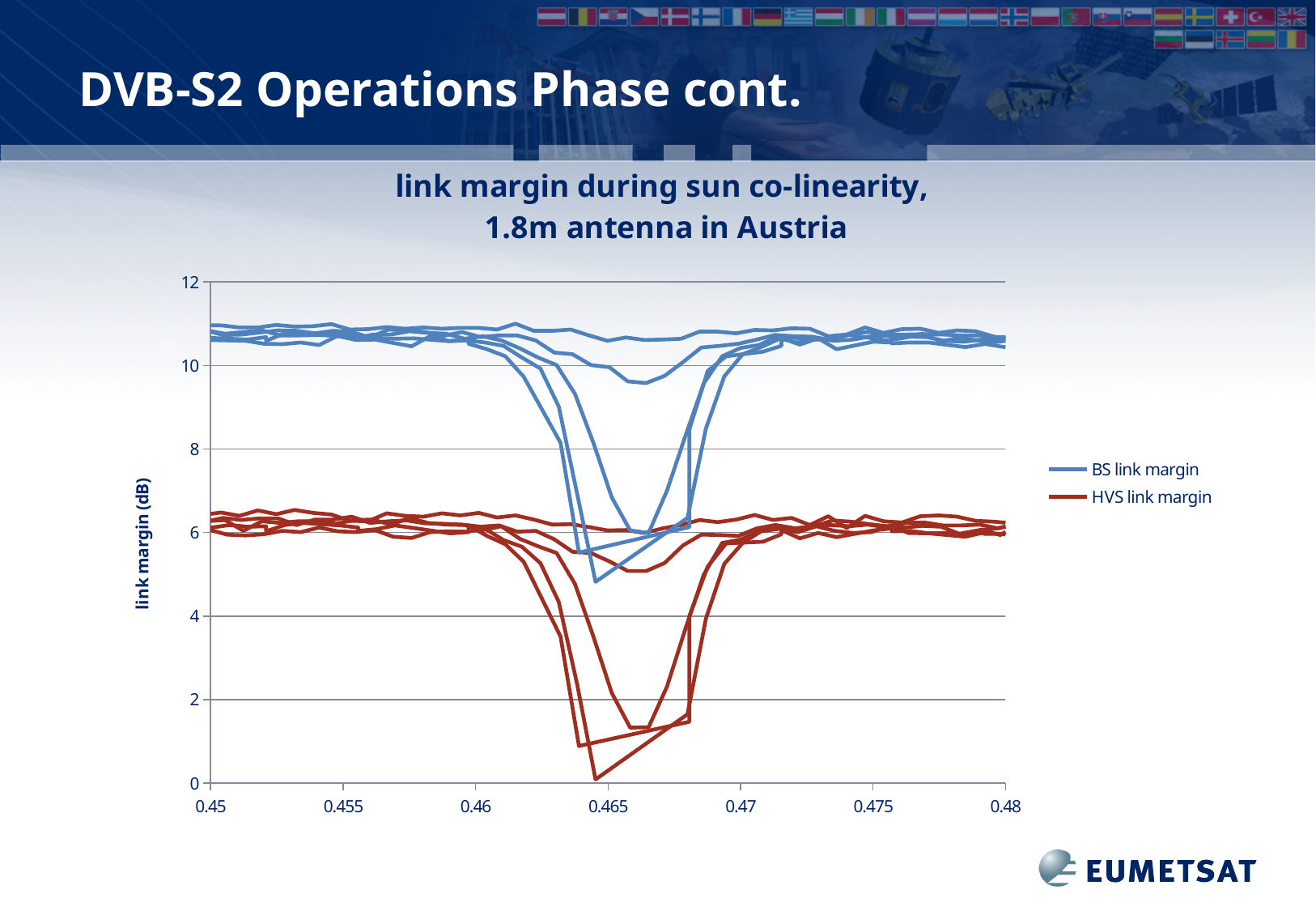
What is the label of the vertical axis? link margin (dB) How many series does the legend list? 2 How many labelled tick marks are on the horizontal axis? 7 What kind of chart is shown on the slide? line chart Is the lowest value reached by the HVS link margin lines greater or less than 2? less What is the title of the chart? link margin during sun co-linearity, 1.8m antenna in Austria At 0.45, which series has the larger value, BS link margin or HVS link margin? BS link margin Is the value for BS link margin at 0.475 greater or less than 12? less Is the value for BS link margin at 0.45 greater or less than 10? greater Which series reaches the lowest value on the chart, BS link margin or HVS link margin? HVS link margin